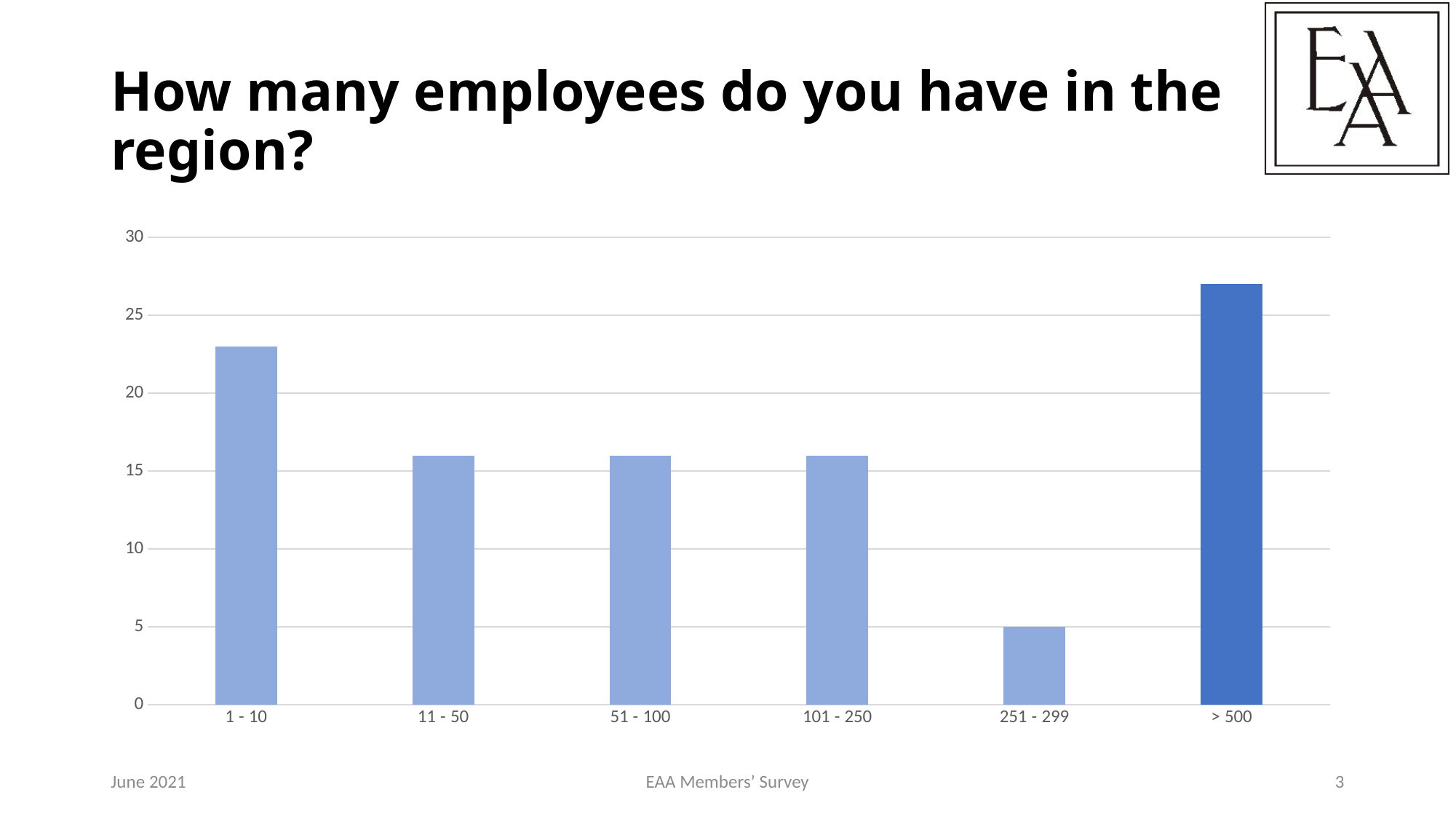
How many employee-size categories are shown on the x axis? 6 Is the value for 11 - 50 greater or less than 20? less Is the value for > 500 greater or less than 25? greater Which is larger, the value for > 500 or the value for 1 - 10? > 500 Which category has the highest bar? > 500 Which category has the lowest bar? 251 - 299 Is the value for 1 - 10 greater or less than 20? greater What type of chart is shown on the slide? bar chart What is the value for the 251 - 299 category? 5 Which bar is shown in a darker shade of blue than the others? > 500 Which is larger, the value for 1 - 10 or the value for 51 - 100? 1 - 10